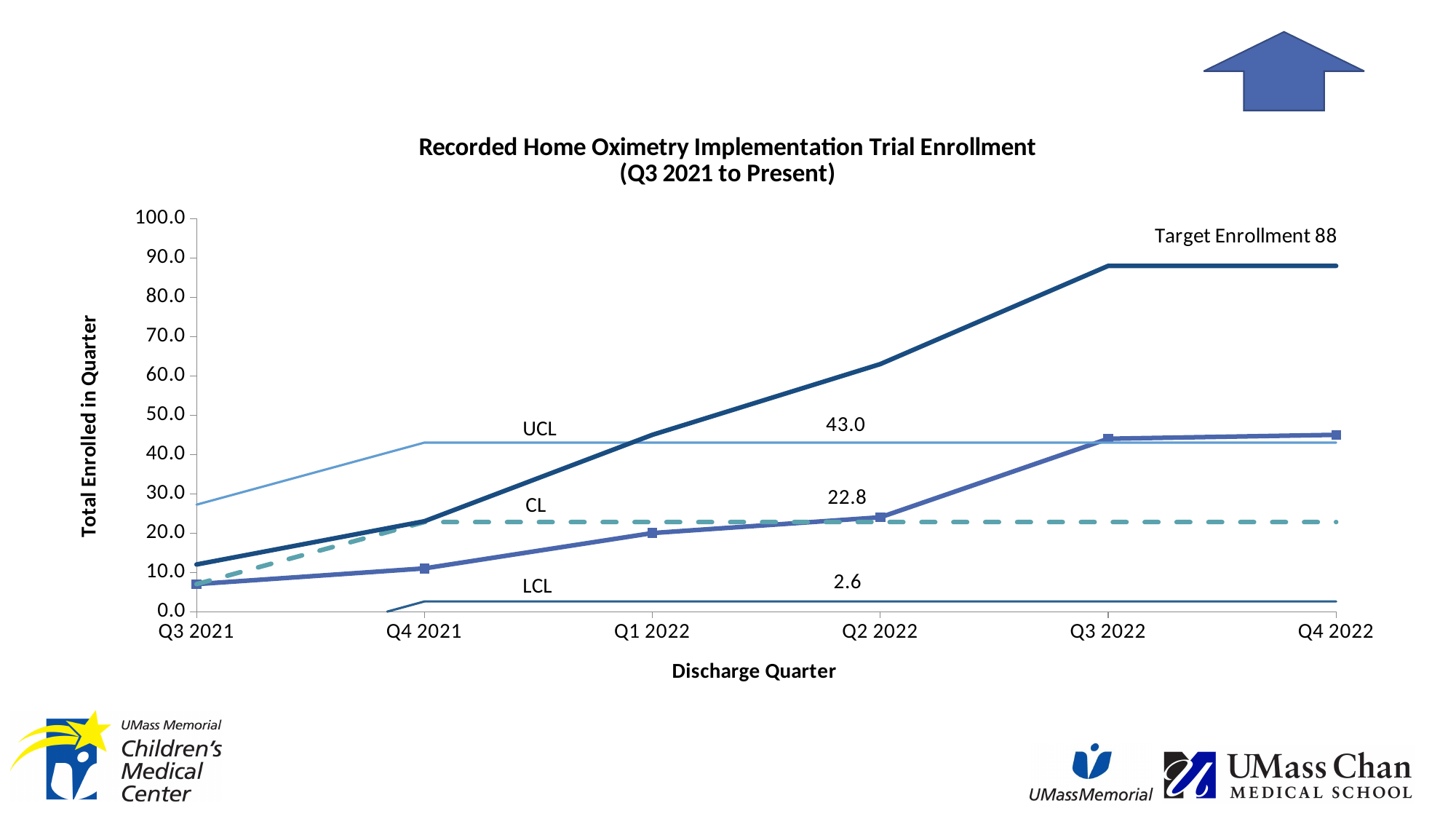
What is the value of the UCL line? 43.0 What is the target enrollment value labelled on the chart? 88 What is the difference between the UCL and the CL values? 20.2 Is the enrolled value for Q3 2022 greater or less than 40? greater What kind of chart is shown on the slide? line chart How many discharge quarters are shown on the x axis? 6 Does the total enrolled line rise or fall from Q3 2021 to Q4 2022? rise What is the title of the x axis? Discharge Quarter What is the value of the CL line? 22.8 Which quarter has the lowest total enrolled? Q3 2021 What is the value of the LCL line? 2.6 Is the enrolled value for Q3 2021 greater or less than 10? less